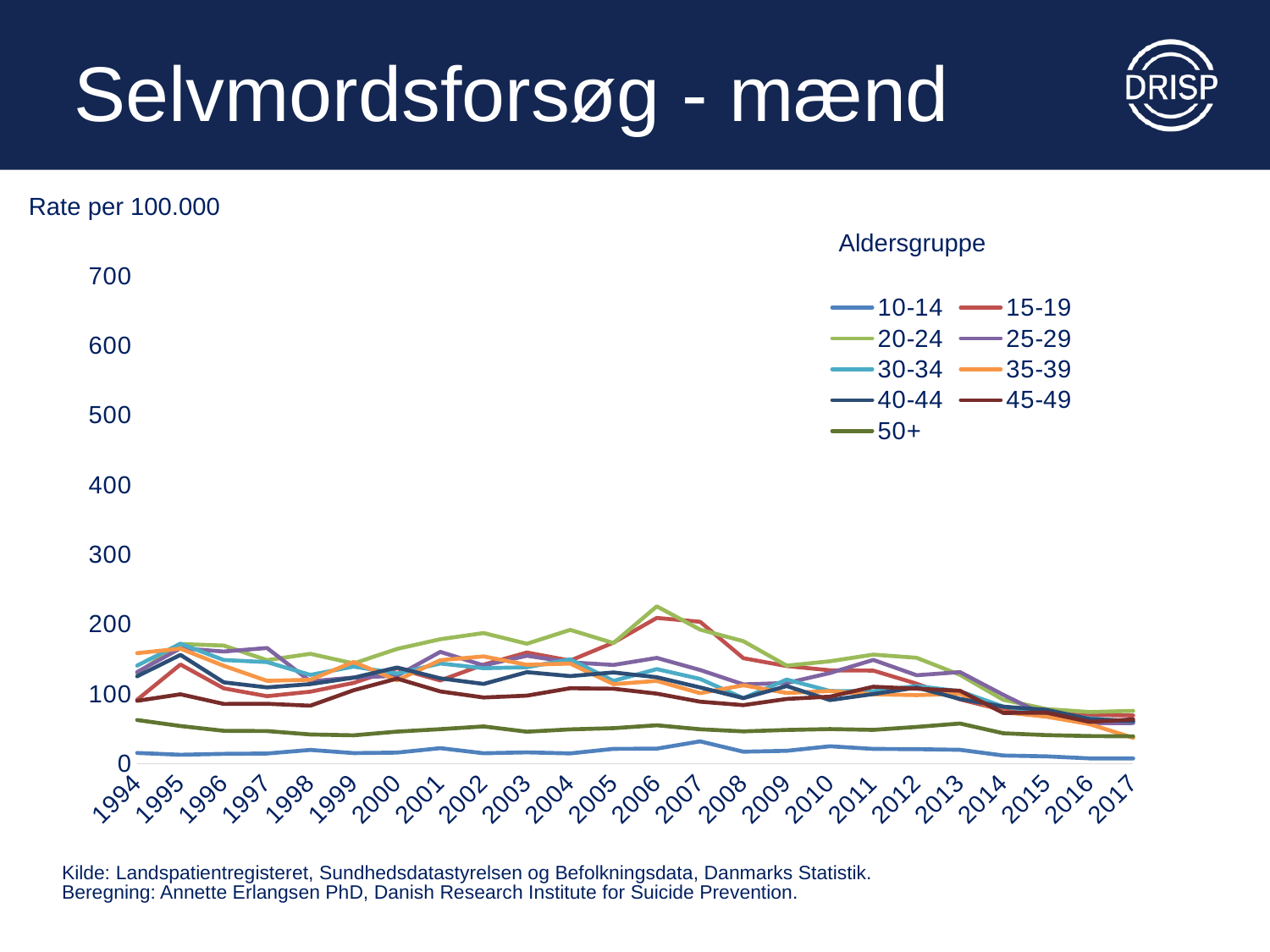
What kind of chart is shown on the slide? line chart In 2010, which is larger: the value for the 50+ age group or the value for the 10-14 age group? 50+ Is the value for the 10-14 age group in 2017 greater or less than 100? less How many age groups does the legend list? 9 What is the title of the chart on the slide? Selvmordsforsøg - mænd How many years are shown along the x axis? 24 Is the value for the 50+ age group in 1994 greater or less than 100? less Is the value for the 20-24 age group in 2006 greater or less than 200? greater Does the value for the 20-24 age group rise or fall from 2013 to 2017? fall What is the first year shown on the x axis? 1994 Which age group has the lowest values across the whole period? 10-14